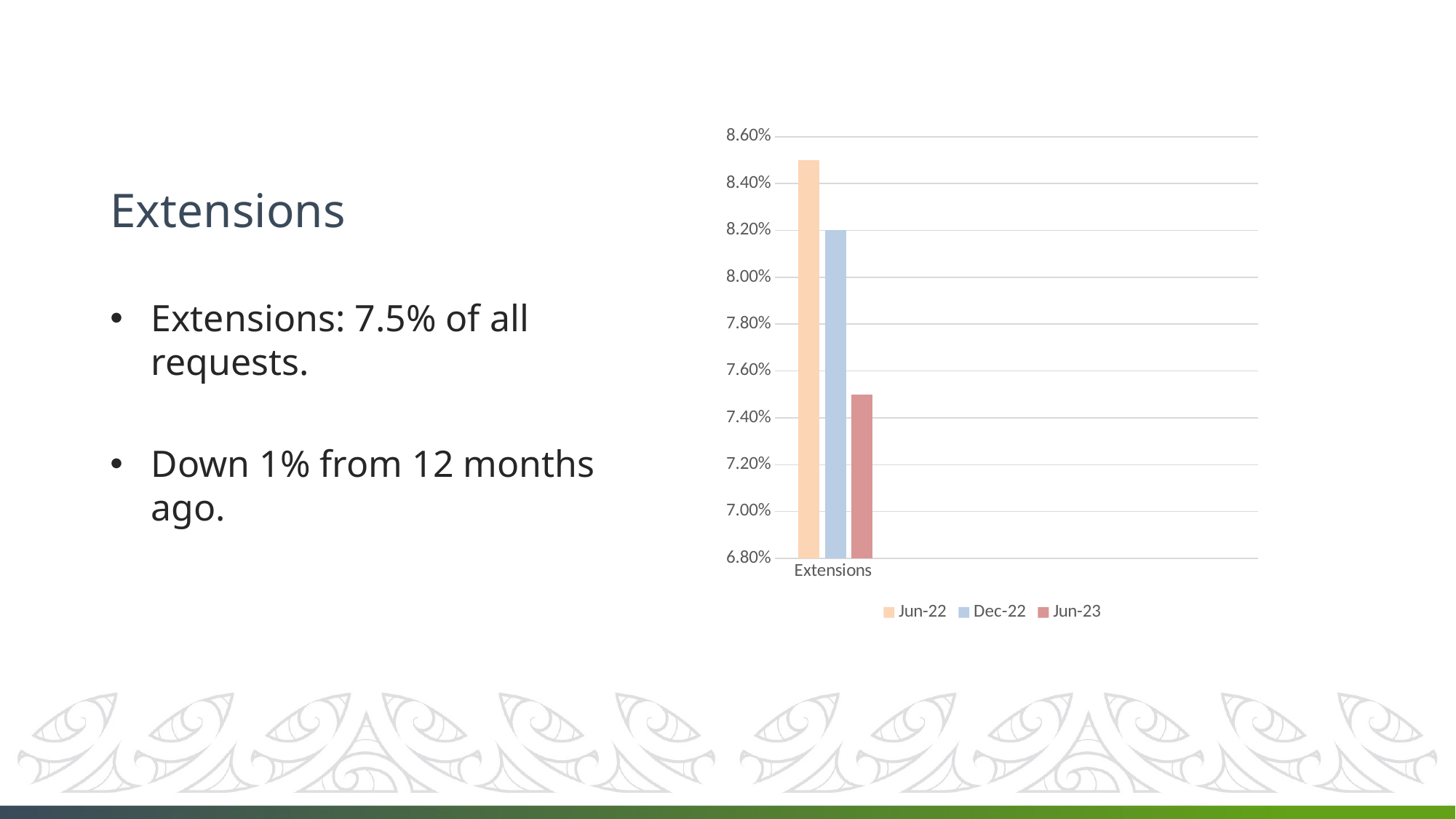
Which series has the highest value for Extensions? Jun-22 Which is larger, the value for Jun-22 or the value for Dec-22? Jun-22 How many series does the legend list? 3 Is the value for Jun-23 greater or less than 7.60%? less How many categories are shown on the x axis? 1 Which series is shown in red? Jun-23 Is the value for Jun-22 greater or less than 8.40%? greater What is the value for Dec-22? 8.20% Is the value for Jun-23 greater or less than 7.40%? greater What is the label of the category on the x axis? Extensions What kind of chart is shown on the slide? bar chart Which series has the lowest value for Extensions? Jun-23